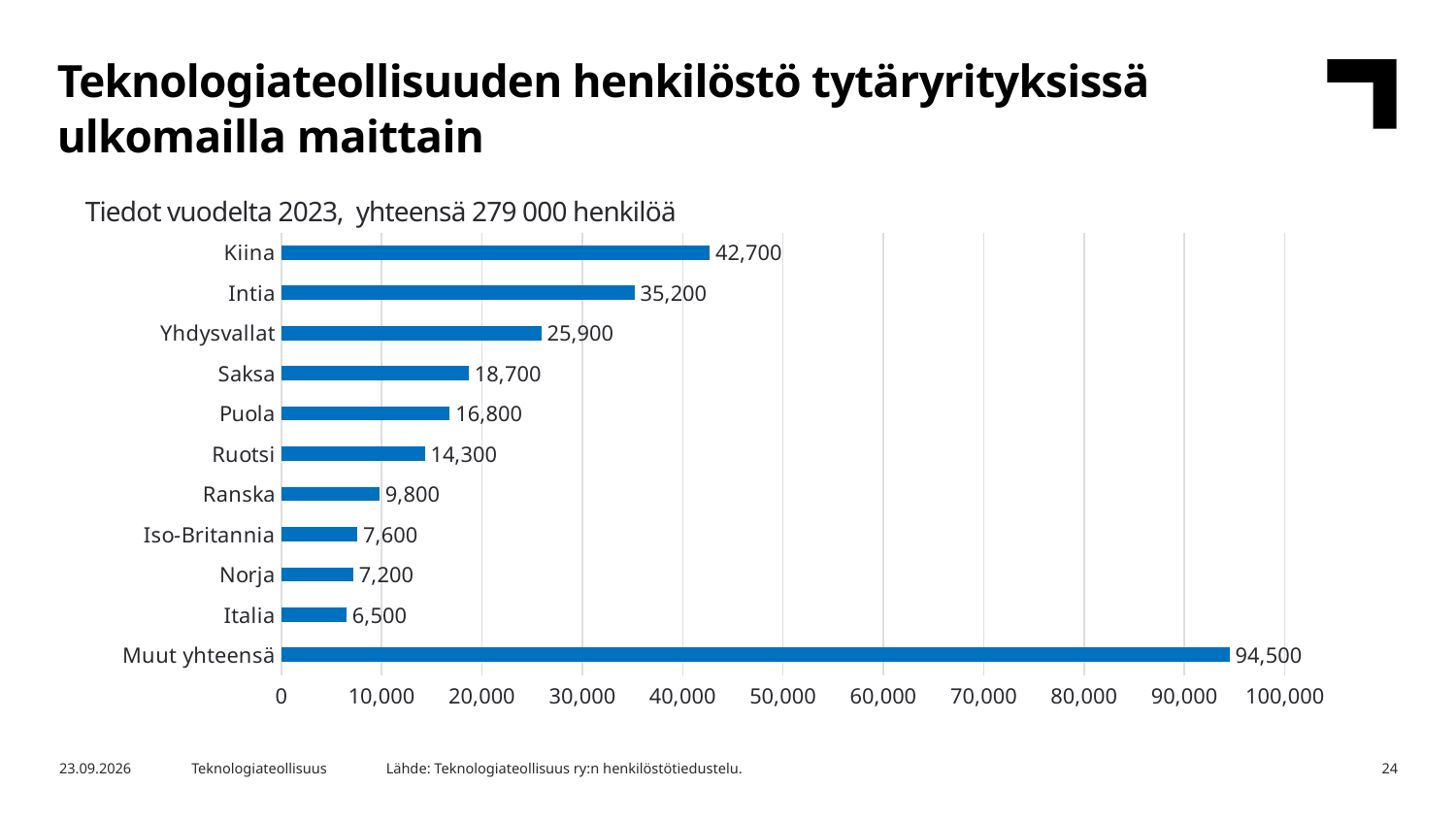
What is the subtitle text shown above the chart? Tiedot vuodelta 2023, yhteensä 279 000 henkilöä What is the difference between the values for Kiina and Intia? 7,500 Is the value for Yhdysvallat greater or less than 20,000? greater Which is larger, the value for Puola or the value for Ruotsi? Puola Which category has the longest bar? Muut yhteensä Which category has the smallest value? Italia What is the value for Kiina? 42,700 What kind of chart is shown on the slide? bar chart What is the difference between the values for Norja and Italia? 700 What is the value for Muut yhteensä? 94,500 What is the value for Saksa? 18,700 How many categories are shown on the chart? 11